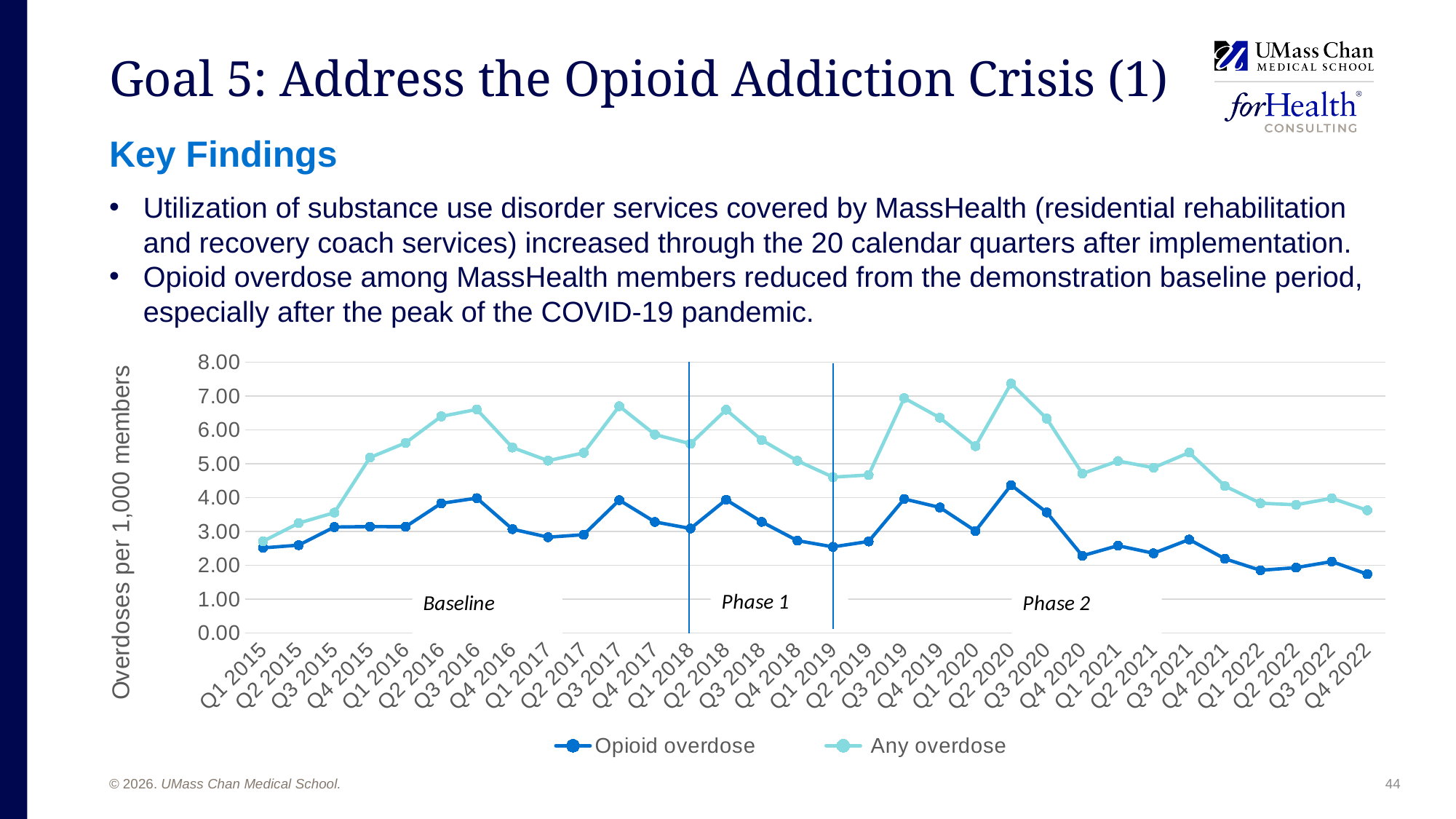
How many quarters are plotted along the x axis? 32 Which series has the higher value in Q3 2019, Opioid overdose or Any overdose? Any overdose Is the Any overdose value for Q3 2016 greater or less than 6.00? greater What is the label on the y axis of the chart? Overdoses per 1,000 members Does the Opioid overdose series rise or fall from Q2 2020 to Q4 2022? Fall In which quarter is the Any overdose series at its lowest value? Q1 2015 Is the Opioid overdose value for Q4 2022 greater or less than 2.00? less In which quarter does the Opioid overdose series reach its highest value? Q2 2020 In which quarter does the Any overdose series reach its highest value? Q2 2020 Is the Any overdose value for Q2 2020 greater or less than 7.00? greater What kind of chart is shown on the slide? Line chart How many series does the legend list? 2